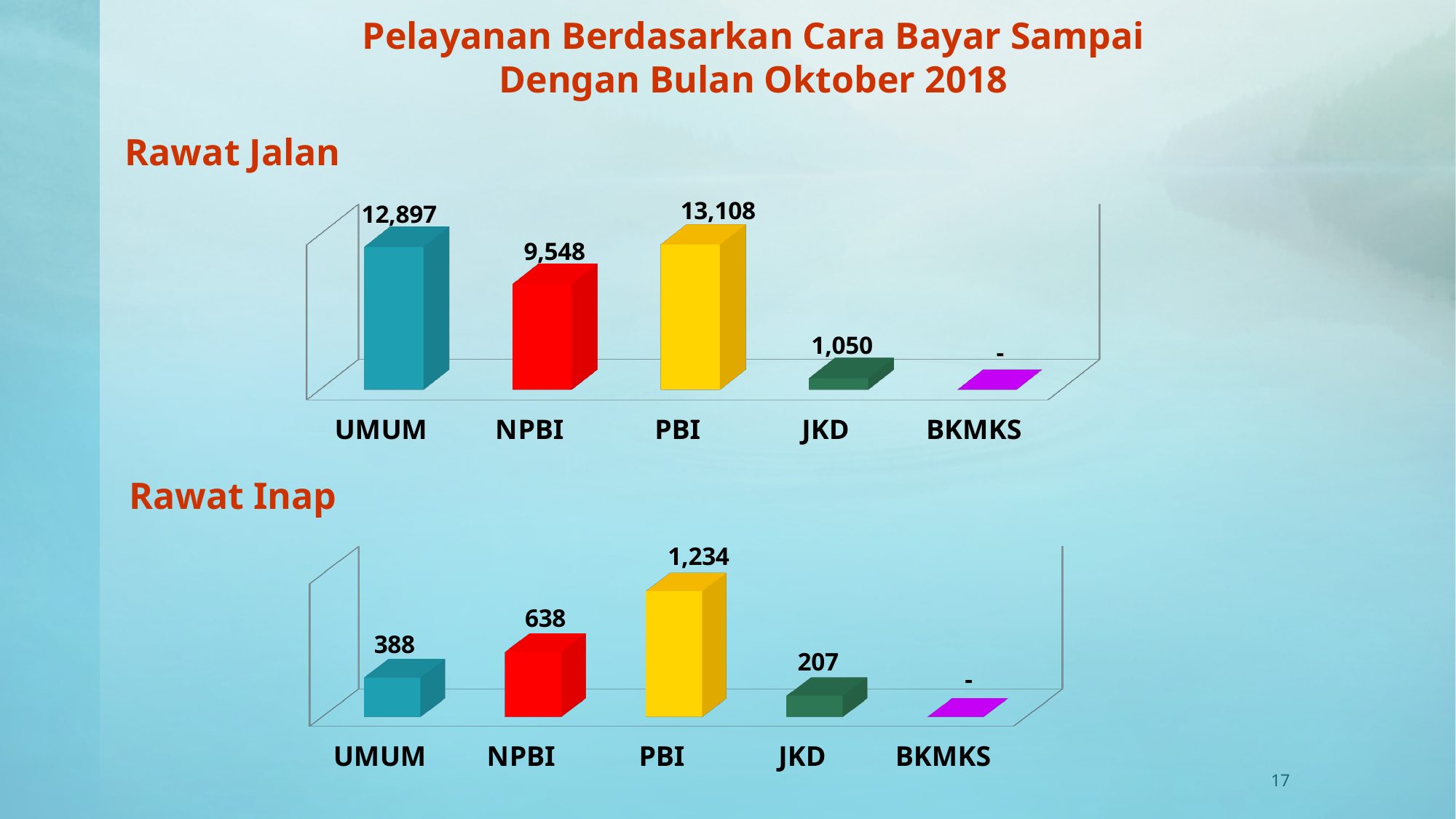
In the Rawat Inap chart, which category has the highest value? PBI What kind of chart is the Rawat Inap chart? Bar chart In the Rawat Inap chart, which is larger, UMUM or NPBI? NPBI In the Rawat Jalan chart, what is the value for UMUM? 12,897 In the Rawat Jalan chart, how many categories are shown on the x axis? 5 In the Rawat Jalan chart, what is the value for JKD? 1,050 In the Rawat Inap chart, what is the value for PBI? 1,234 In the Rawat Inap chart, what is the difference between the NPBI and UMUM values? 250 In the Rawat Inap chart, what is the value for NPBI? 638 In the Rawat Jalan chart, what colour is the PBI bar? Yellow In the Rawat Jalan chart, which category has the highest value? PBI In the Rawat Jalan chart, what is the difference between the PBI and UMUM values? 211